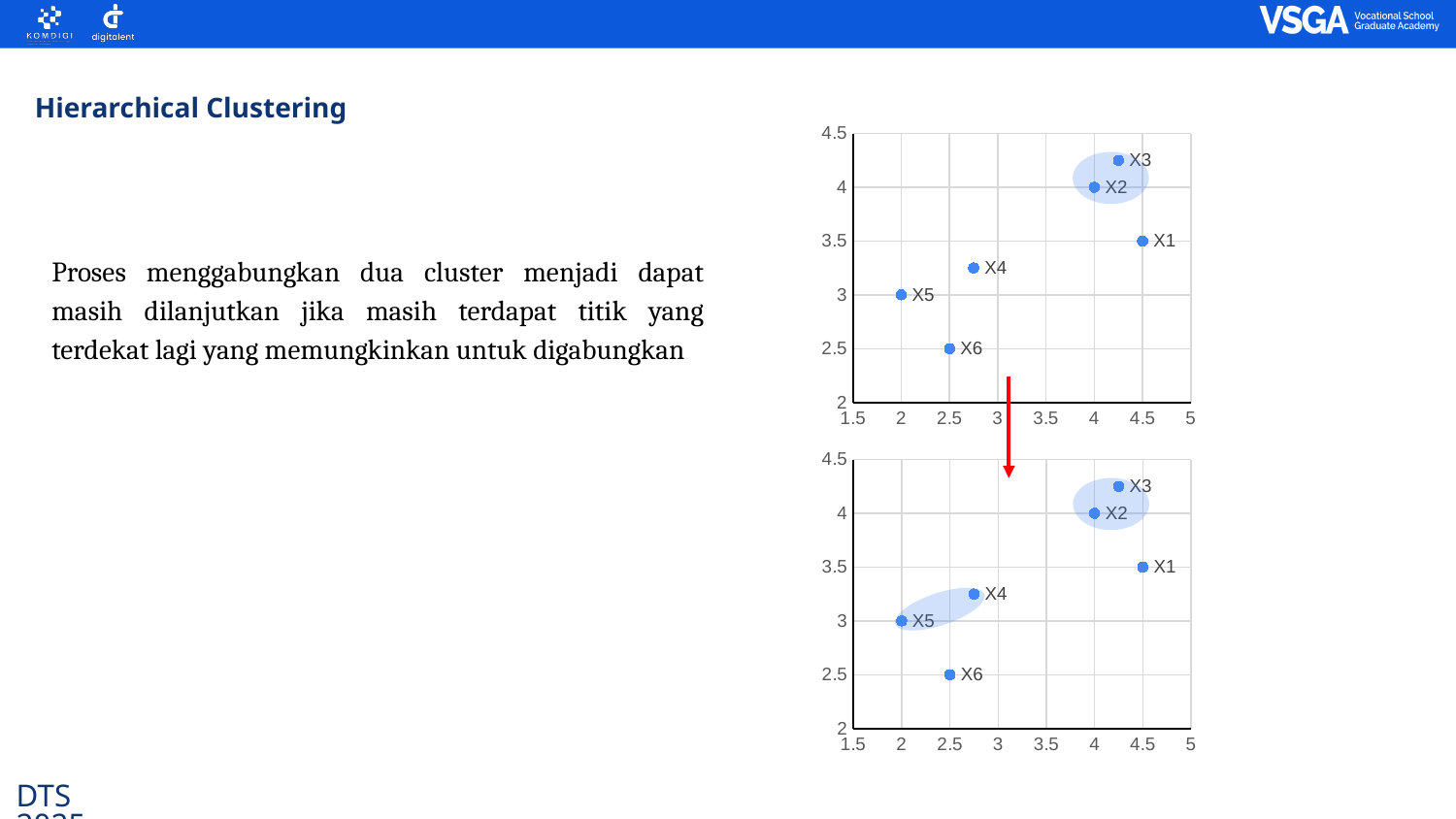
In the top chart, which point has the highest y-axis value? X3 In the top chart, what is the y-axis value of point X5? 3 In the bottom chart, which point has a larger y-axis value, X1 or X4? X1 In the top chart, is the y-axis value of point X4 greater or less than 3? greater In the bottom chart, which point has the lowest x-axis value? X5 How many labelled data points are plotted in the top chart? 6 In the bottom chart, which two points are enclosed together in the newly added highlighted ellipse on the left? X4 and X5 In the bottom chart, what is the x-axis value of point X1? 4.5 What kind of chart is the top chart on the slide? scatter chart In the top chart, which point has the lowest y-axis value? X6 In the bottom chart, what is the y-axis value of point X6? 2.5 In the top chart, what is the x-axis value of point X2? 4